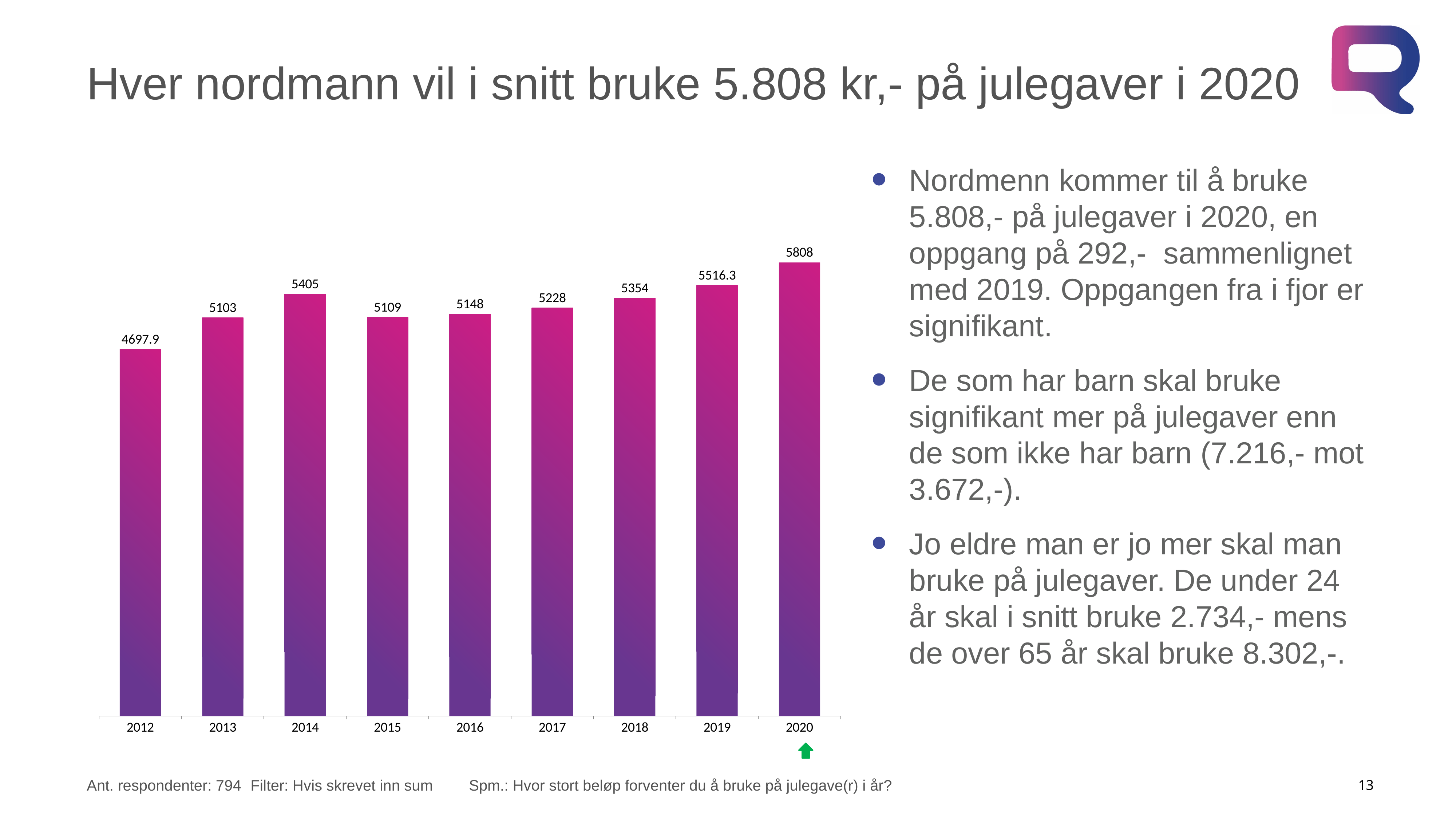
Which year has the lowest value? 2012 What is the value for 2012? 4697.9 What is the value for 2019? 5516.3 How many years are shown on the x axis? 9 What is the difference between the values for 2020 and 2019? 291.7 Which is larger, the value for 2014 or the value for 2015? 2014 What is the difference between the values for 2014 and 2013? 302 What is the value for 2016? 5148 Do the values generally rise or fall from 2015 to 2020? rise What kind of chart is shown on the slide? bar chart Which year has the highest value? 2020 Which is larger, the value for 2017 or the value for 2018? 2018